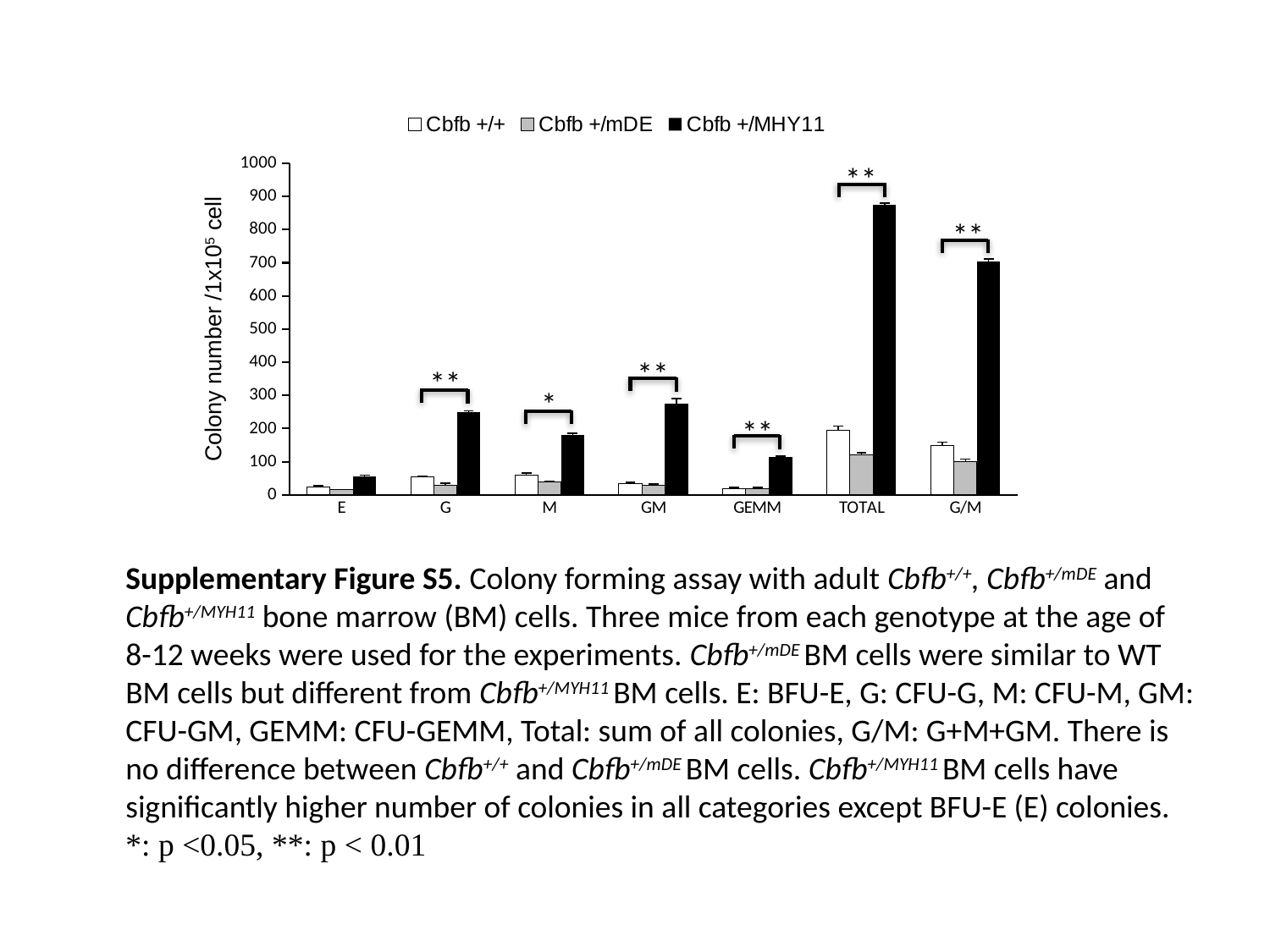
Which is larger, the Cbfb +/MHY11 value for GM or for M? GM Is the Cbfb +/MHY11 value for TOTAL greater or less than 800? greater Which category has the lowest Cbfb +/MHY11 bar? E What is the label on the y axis of the chart? Colony number /1x10⁵ cell Which category has the highest Cbfb +/MHY11 bar? TOTAL How many series does the legend list? 3 How many categories are shown along the x axis of the chart? 7 Which is larger, the Cbfb +/+ value for TOTAL or for G/M? TOTAL Is the Cbfb +/+ value for TOTAL greater or less than 100? greater Is the Cbfb +/MHY11 value for G/M greater or less than 600? greater What kind of chart is shown on the slide? bar chart